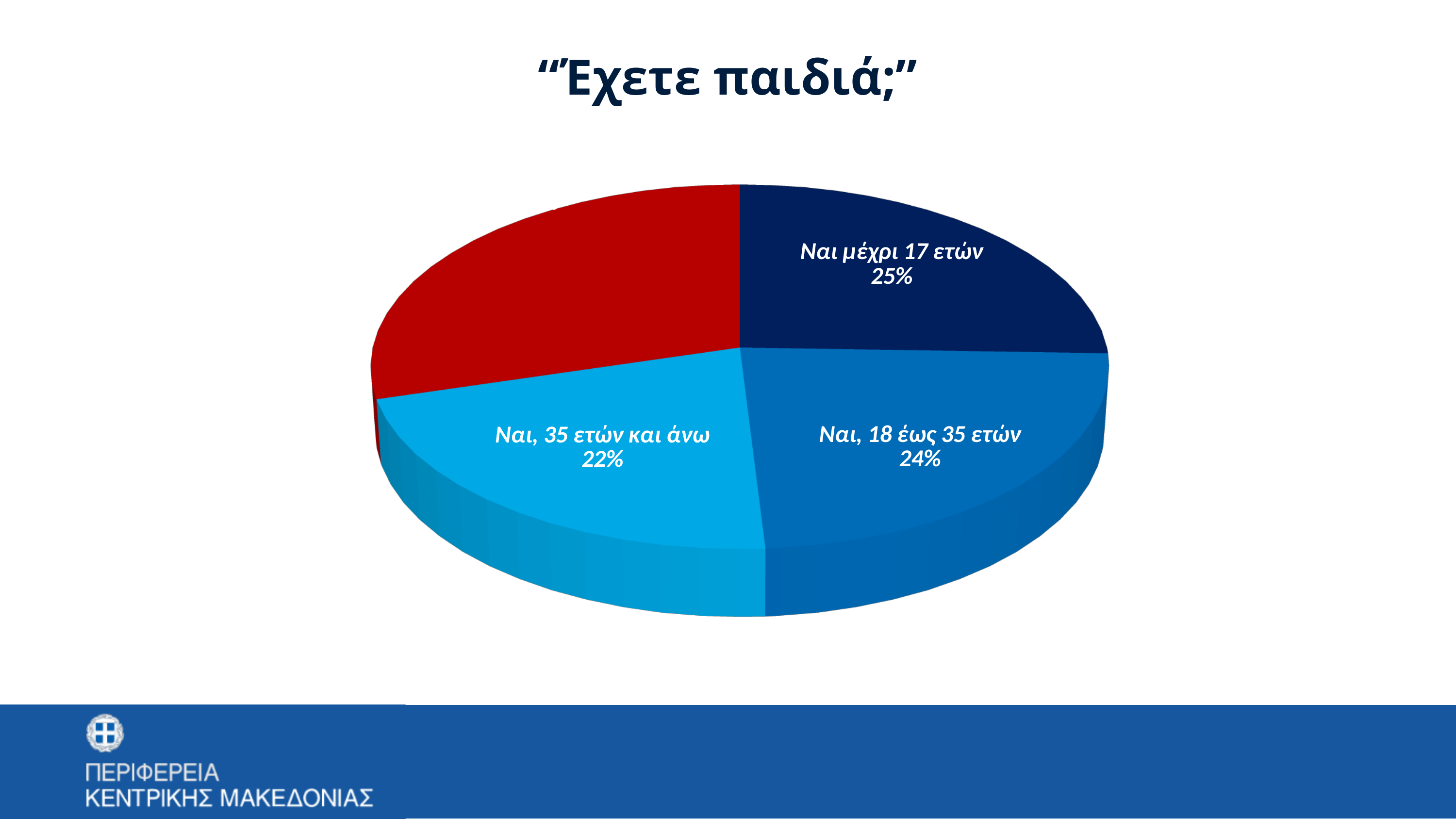
What is the title of the chart? "Έχετε παιδιά;" Which is larger, the slice for "Ναι, 18 έως 35 ετών" or the slice for "Ναι, 35 ετών και άνω"? Ναι, 18 έως 35 ετών What is the difference in percentage points between "Ναι μέχρι 17 ετών" and "Ναι, 35 ετών και άνω"? 3 What is the difference in percentage points between "Ναι, 18 έως 35 ετών" and "Ναι, 35 ετών και άνω"? 2 What percentage is shown for "Ναι, 18 έως 35 ετών"? 24% What percentage is shown for "Ναι μέχρι 17 ετών"? 25% Which is larger, the slice for "Ναι μέχρι 17 ετών" or the slice for "Ναι, 35 ετών και άνω"? Ναι μέχρι 17 ετών What colour is the slice labelled "Ναι, 35 ετών και άνω"? light blue What percentage is shown for "Ναι, 35 ετών και άνω"? 22% How many slices does the pie chart have? 4 Which of the three labelled slices has the smallest share? Ναι, 35 ετών και άνω What kind of chart is shown on the slide? pie chart